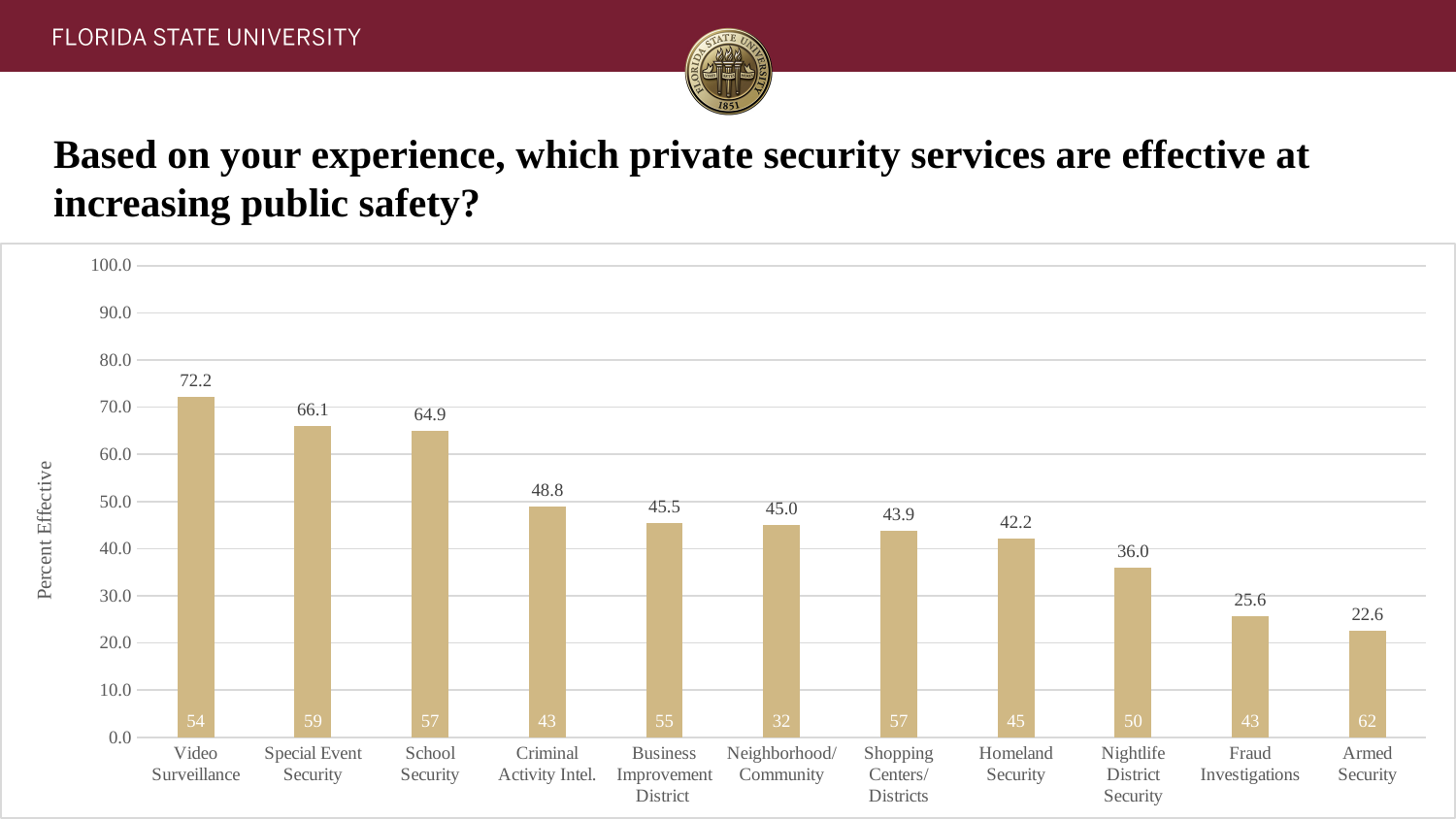
What kind of chart is shown on the slide? bar chart What is the percent effective value for Video Surveillance? 72.2 How many private security service categories are shown on the chart? 11 Which private security service has the lowest percent effective value? Armed Security Which has a higher percent effective value, Criminal Activity Intel. or Nightlife District Security? Criminal Activity Intel. What is the label on the vertical axis of the chart? Percent Effective What is the difference in percent effective between Video Surveillance and Armed Security? 49.6 What is the percent effective value for Fraud Investigations? 25.6 Which private security service has the highest percent effective value? Video Surveillance What is the difference in percent effective between Special Event Security and School Security? 1.2 Is the value for Shopping Centers/Districts greater or less than 50.0? less What is the percent effective value for Homeland Security? 42.2